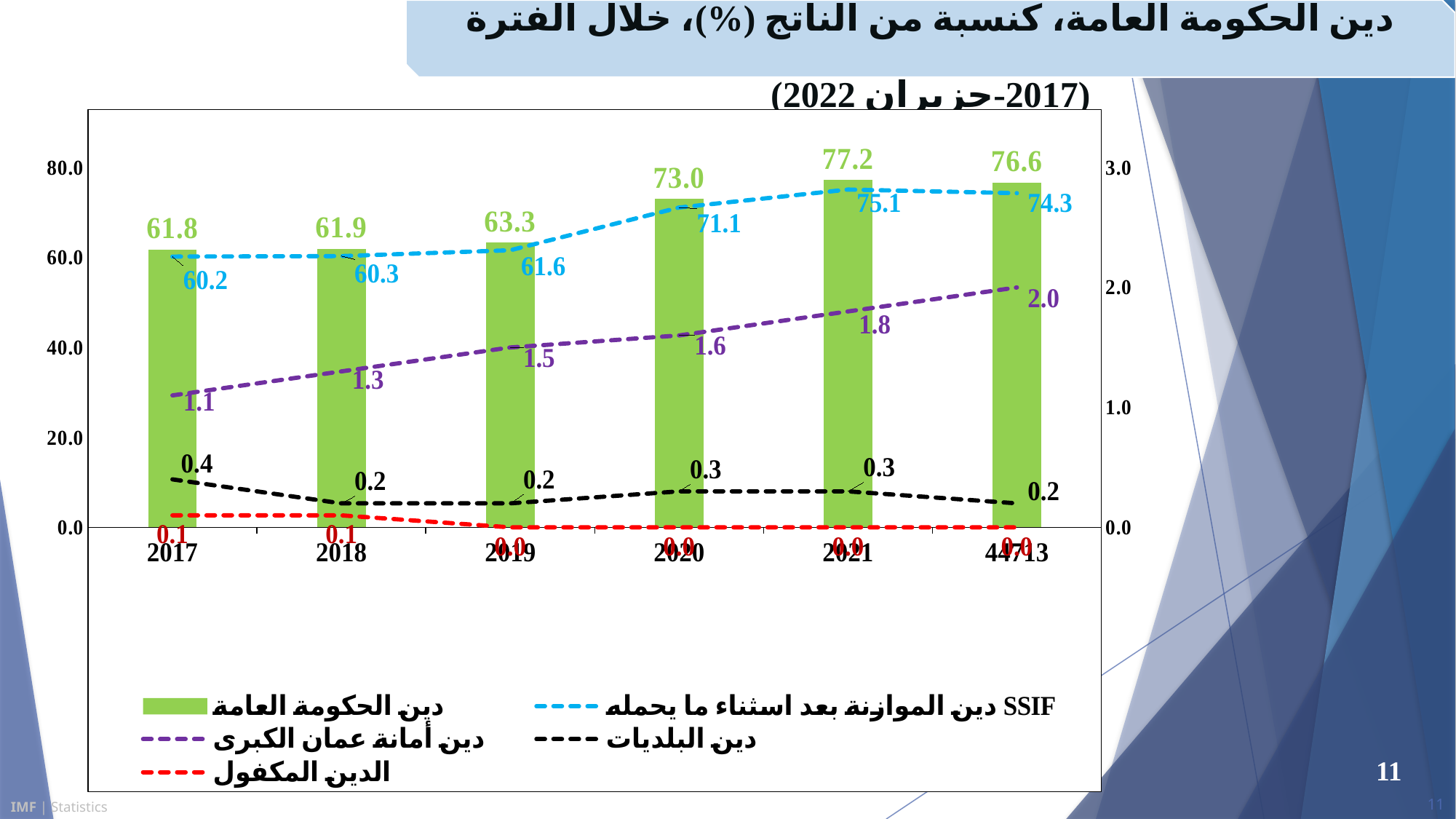
What is the value of the blue dashed line (دين الموازنة بعد استثناء ما يحمله SSIF) for 2020? 71.1 What is the value of the black dashed line (دين البلديات) for 2017? 0.4 Does the purple dashed line (دين أمانة عمان الكبرى) rise or fall from 2017 to 2021? rise In which year is the green bar (دين الحكومة العامة) lowest? 2017 How many series does the legend list? 5 What is the value of the green bar (دين الحكومة العامة) for 2021? 77.2 What is the difference between the green bar values for 2020 and 2019? 9.7 In which year is the green bar (دين الحكومة العامة) highest? 2021 What is the value of the purple dashed line (دين أمانة عمان الكبرى) for 2019? 1.5 What colour are the bars representing دين الحكومة العامة? green Which is larger, the green bar value for 2018 or for 2019? 2019 What is the value of the red dashed line (الدين المكفول) for 2018? 0.1